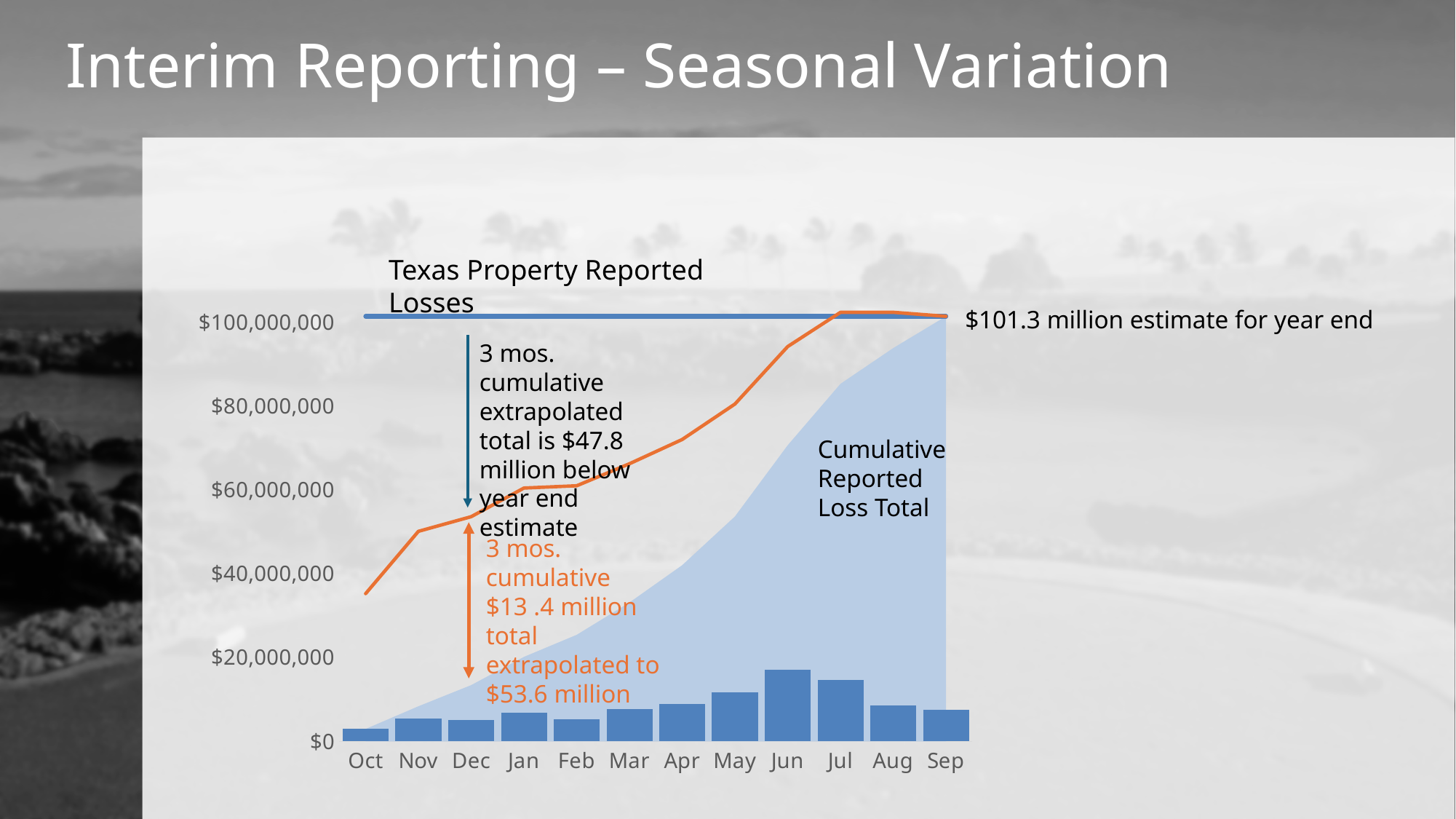
How many months are shown on the x axis of the chart? 12 Which month has a taller bar, May or Feb? May Does the Cumulative Reported Loss Total rise or fall from Oct to Sep? rise Which month has the tallest bar in the chart? Jun According to the annotation, what does the 3-month cumulative total extrapolate to? $53.6 million Is the Cumulative Reported Loss Total at Sep greater or less than $80,000,000? greater According to the annotation, what is the 3-month cumulative total? $13.4 million Which month has the shortest bar in the chart? Oct What is the title of the chart? Texas Property Reported Losses Which month has a taller bar, Jun or Jul? Jun What is the year-end estimate shown on the chart? $101.3 million According to the annotation, how much is the 3-month cumulative extrapolated total below the year-end estimate? $47.8 million